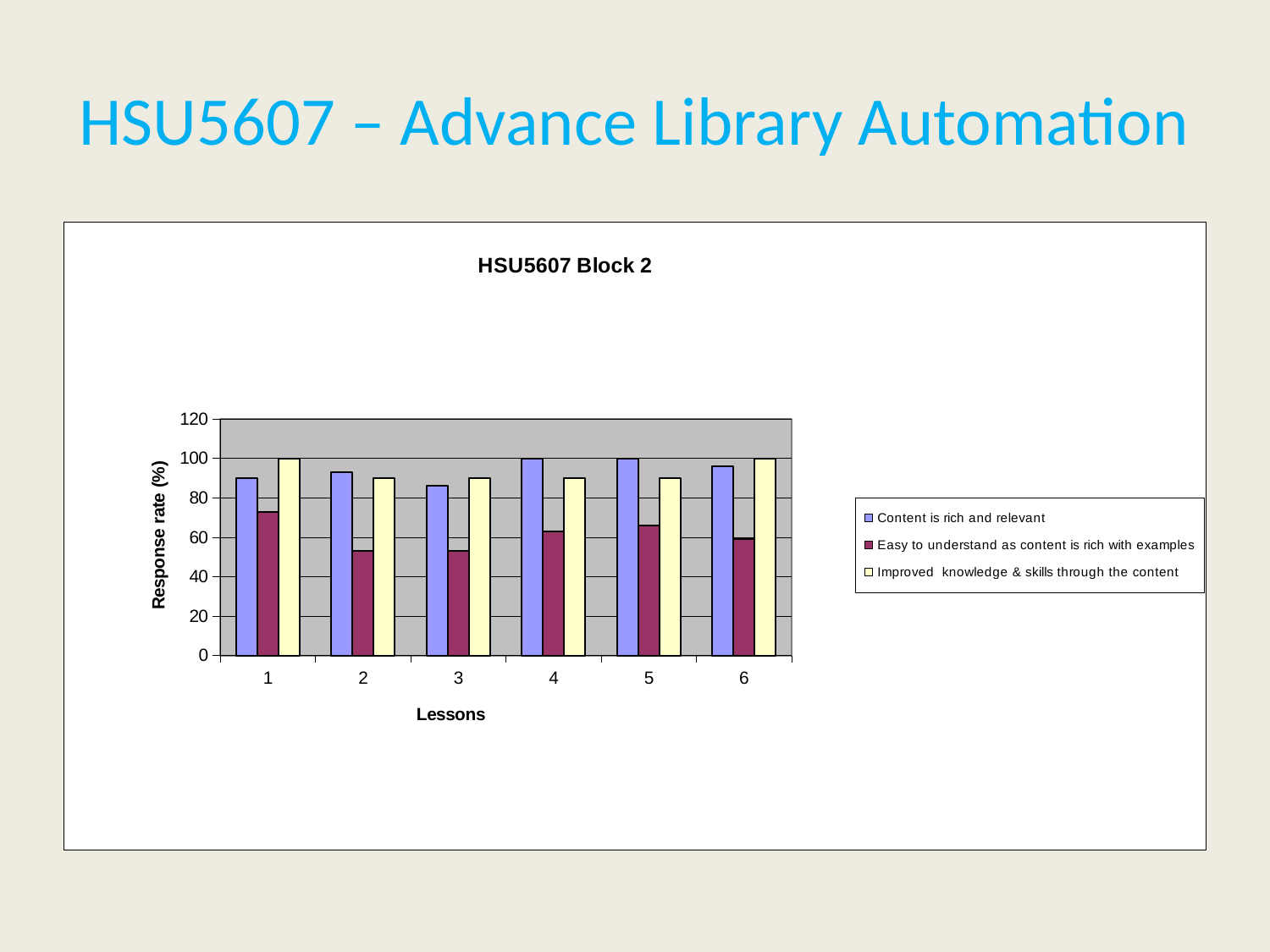
What kind of chart is shown on the slide? bar chart How many lessons are shown on the x axis? 6 What is the label of the y axis? Response rate (%) Is the value for 'Content is rich and relevant' at lesson 3 greater or less than 80? greater Is the value for 'Easy to understand as content is rich with examples' at lesson 2 greater or less than 60? less Which is larger for 'Easy to understand as content is rich with examples': lesson 1 or lesson 2? lesson 1 What is the value for 'Improved knowledge & skills through the content' at lesson 1? 100 What is the value for 'Content is rich and relevant' at lesson 4? 100 How many series does the legend list? 3 For which lesson is 'Easy to understand as content is rich with examples' highest? 1 What is the title of the chart? HSU5607 Block 2 Is the value for 'Easy to understand as content is rich with examples' at lesson 1 greater or less than 60? greater